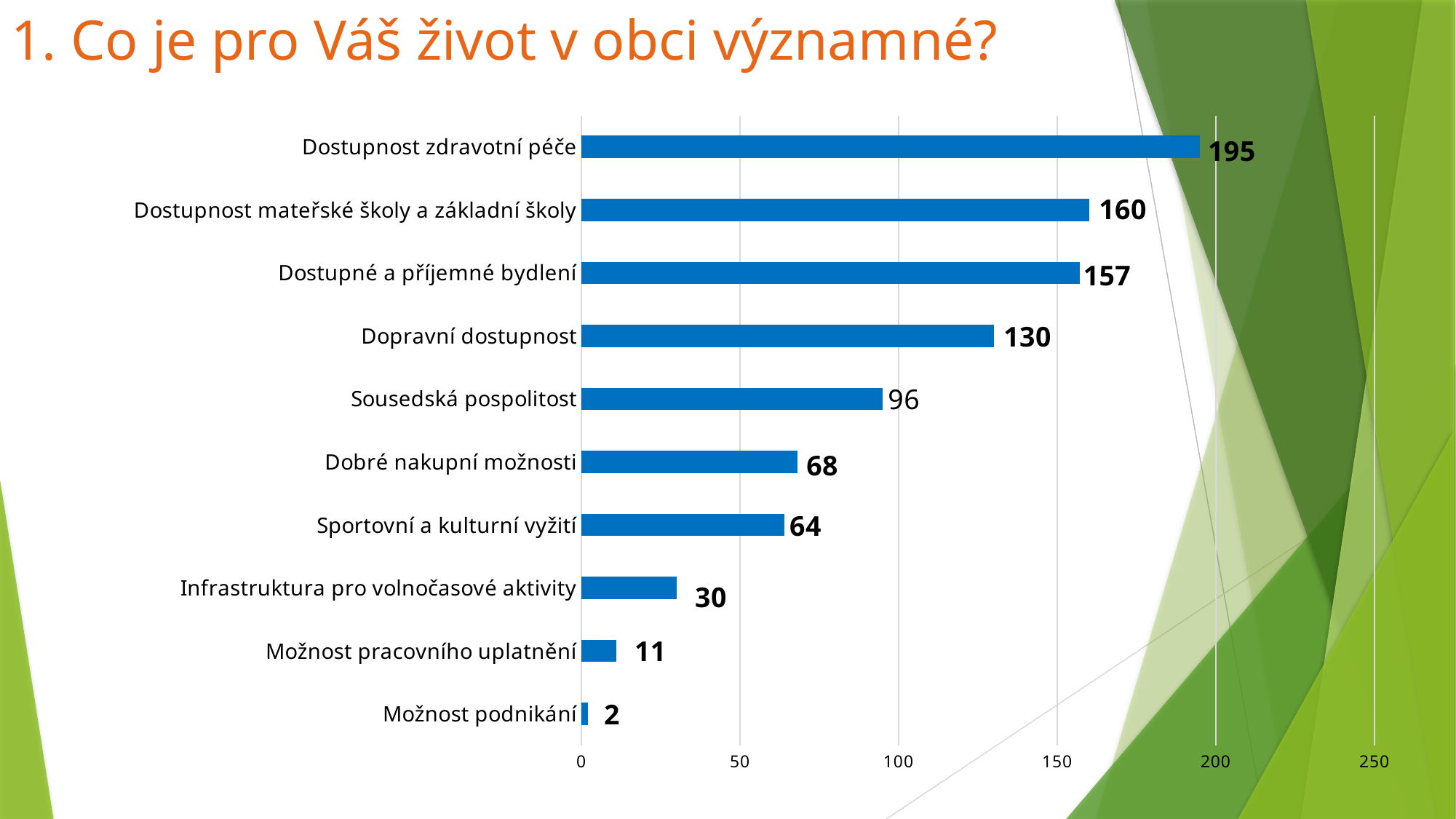
What is the value for Infrastruktura pro volnočasové aktivity? 30 Which category has the highest value? Dostupnost zdravotní péče Which is larger, the value for Dobré nakupní možnosti or the value for Sportovní a kulturní vyžití? Dobré nakupní možnosti What is the value for Dostupnost zdravotní péče? 195 What is the difference between the values for Možnost pracovního uplatnění and Možnost podnikání? 9 Is the value for Dopravní dostupnost greater or less than 100? greater What is the title of the slide? 1. Co je pro Váš život v obci významné? Which category has the lowest value? Možnost podnikání What kind of chart is shown on the slide? bar chart What is the value for Sousedská pospolitost? 96 How many categories are shown in the chart? 10 What is the difference between the values for Dostupnost mateřské školy a základní školy and Dopravní dostupnost? 30